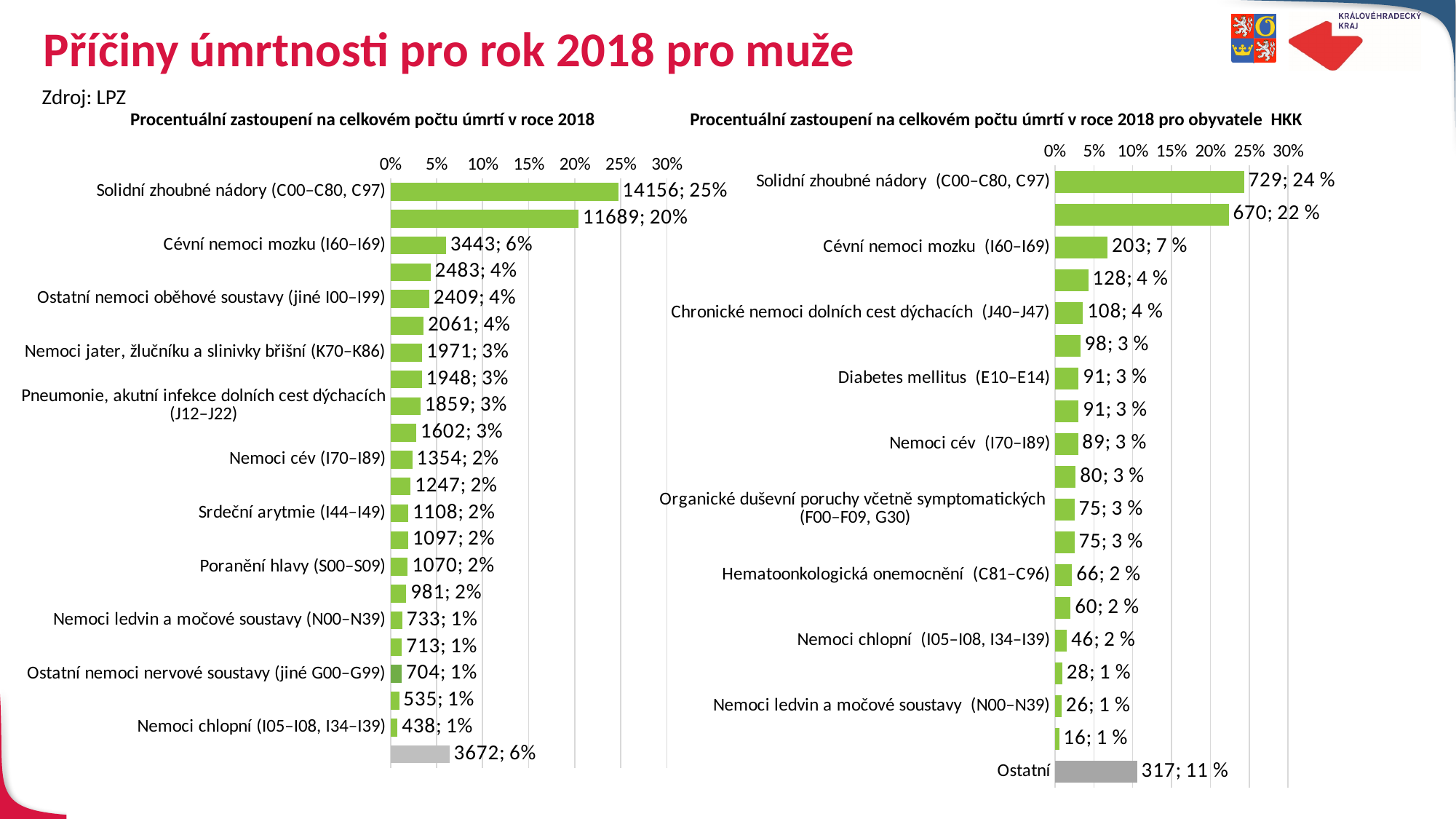
What type of chart is used on this slide? Bar chart In the left chart, what is the difference in counts between Solidní zhoubné nádory (C00–C80, C97) and Cévní nemoci mozku (I60–I69)? 10713 In the right chart (pro obyvatele HKK), which labelled category has the highest value? Solidní zhoubné nádory (C00–C80, C97) In the right chart (pro obyvatele HKK), what is the difference in counts between Nemoci chlopní (I05–I08, I34–I39) and Nemoci ledvin a močové soustavy (N00–N39)? 20 In the left chart, which is larger: the count for Nemoci cév (I70–I89) or for Srdeční arytmie (I44–I49)? Nemoci cév (I70–I89) In the right chart (pro obyvatele HKK), what is the data label for Diabetes mellitus (E10–E14)? 91; 3 % How many bars are plotted in the right chart (pro obyvatele HKK)? 19 In the left chart, what is the data label for Nemoci chlopní (I05–I08, I34–I39)? 438; 1% In the left chart, what is the data label for Cévní nemoci mozku (I60–I69)? 3443; 6% In the right chart (pro obyvatele HKK), what is the data label for Ostatní? 317; 11 % In the left chart (Procentuální zastoupení na celkovém počtu úmrtí v roce 2018), what is the data label for Solidní zhoubné nádory (C00–C80, C97)? 14156; 25% In the right chart (pro obyvatele HKK), what is the data label for Cévní nemoci mozku (I60–I69)? 203; 7 %